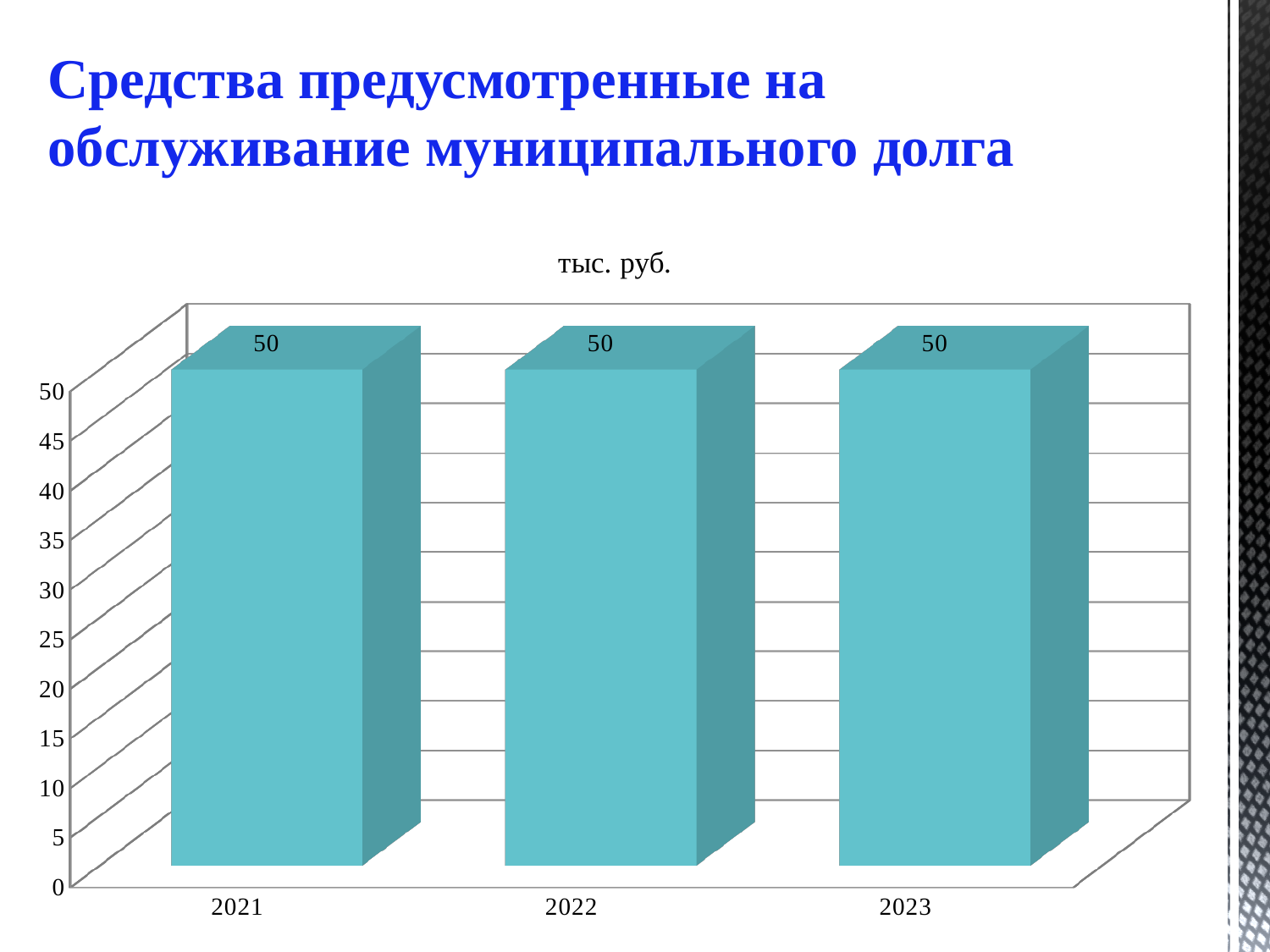
What is the value for 2021? 50 Is the value for 2022 greater or less than 40? greater What is the highest value shown on the vertical axis? 50 What is the value for 2022? 50 What unit label is shown above the chart? тыс. руб. Do the values rise, fall or stay the same from 2021 to 2023? stay the same What is the value for 2023? 50 What is the difference between the values for 2021 and 2023? 0 What kind of chart is shown on the slide? bar chart How many categories are shown on the x axis? 3